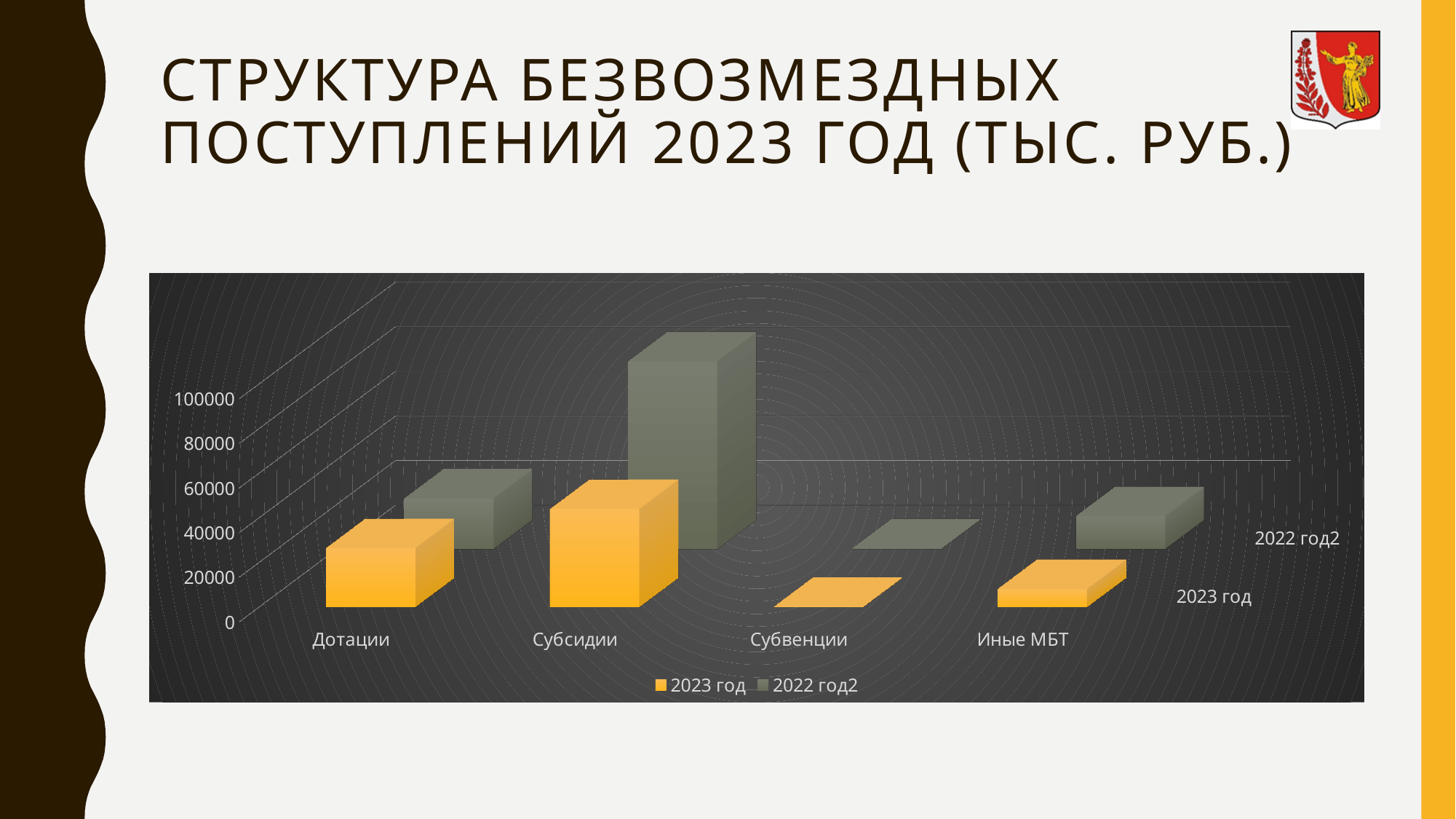
What are the two series names listed in the chart legend? 2023 год and 2022 год2 Which category has the highest value for the 2022 год2 series? Субсидии Which category has the highest value for the 2023 год series? Субсидии Is the 2023 год value for Субвенции greater or less than 20000? less What type of chart is shown on the slide? Bar chart Which category has the lowest value for the 2022 год2 series? Субвенции Is the 2023 год value for Дотации greater or less than 20000? greater How many categories are shown on the x axis of the chart? 4 Which category has the lowest value for the 2023 год series? Субвенции How many series does the chart legend list? 2 Is the 2023 год value for Субсидии greater or less than 40000? greater For the 2023 год series, which is larger: Дотации or Субсидии? Субсидии